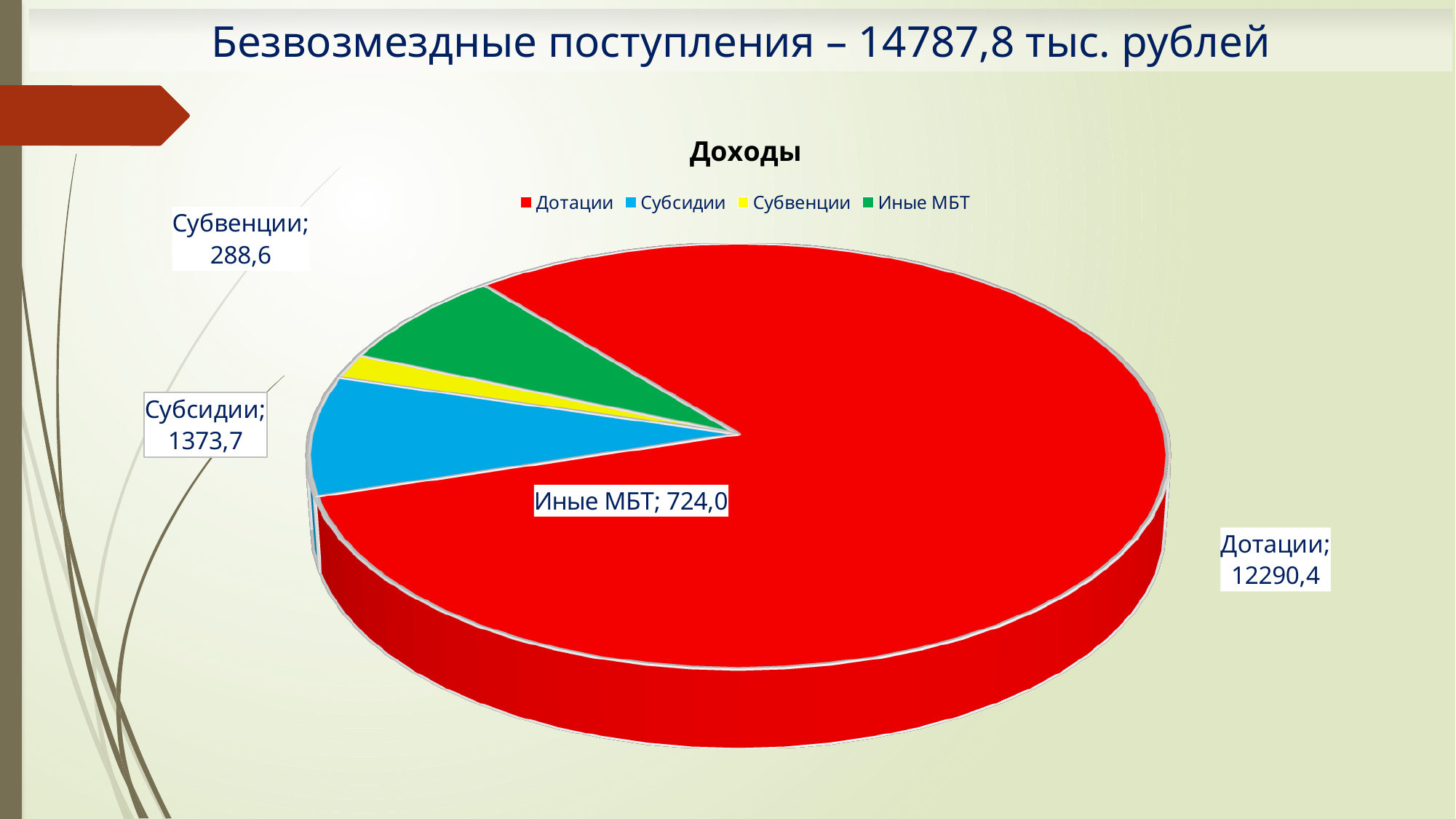
Which is larger, Субсидии or Иные МБТ? Субсидии What is the value for Субвенции? 288,6 What is the title of the chart? Доходы What is the value for Дотации? 12290,4 What is the value for Иные МБТ? 724,0 What is the value for Субсидии? 1373,7 Which category has the smallest slice of the pie? Субвенции What is the difference between the values for Субсидии and Иные МБТ? 649,7 How many slices does the pie chart have? 4 What is the difference between the values for Иные МБТ and Субвенции? 435,4 What kind of chart is shown on the slide? Pie chart Which category has the largest slice of the pie? Дотации